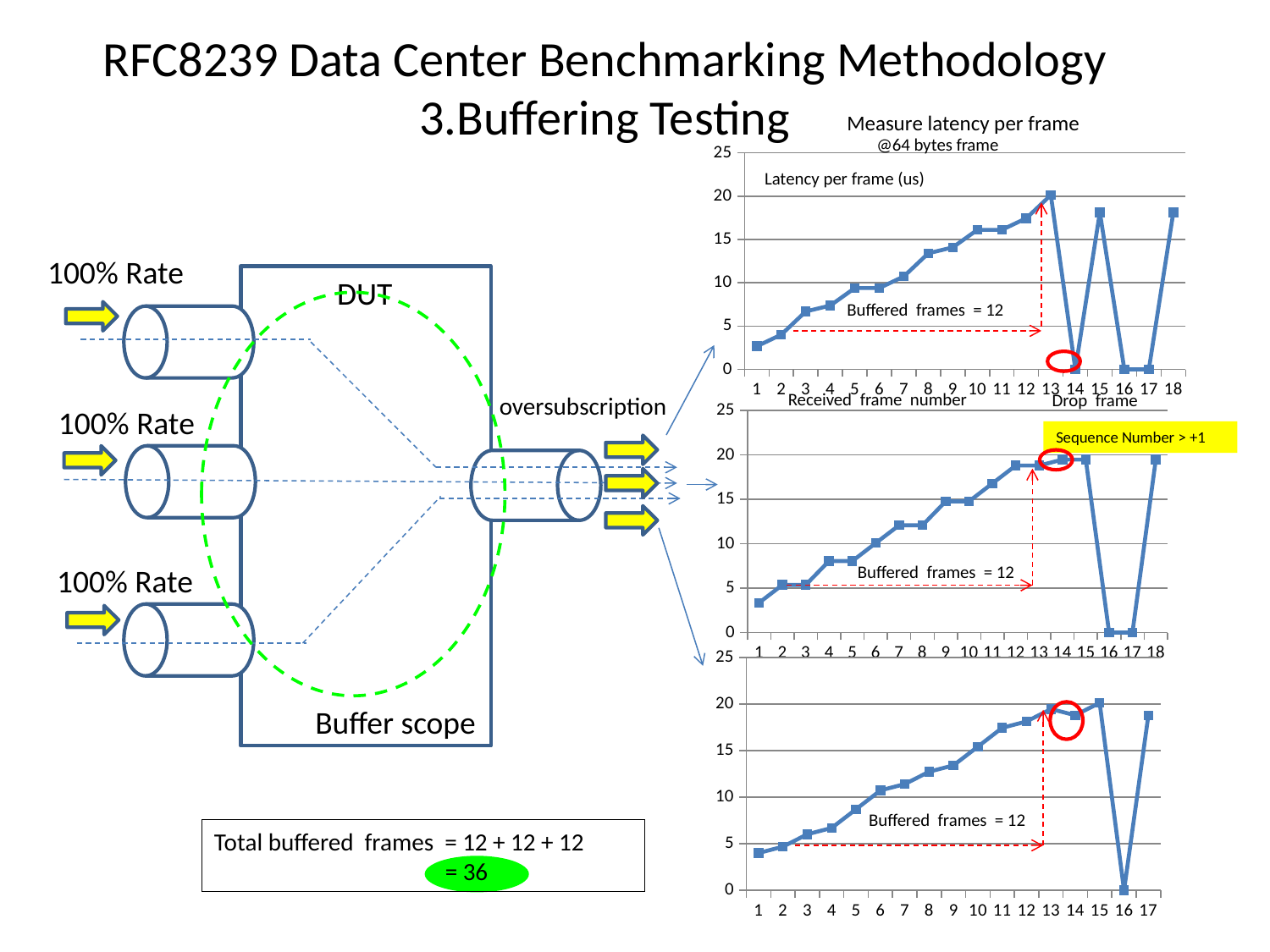
In the bottom chart, is the latency for frame 15 greater or less than 15? greater What type of chart is the top chart on the right of the slide? line chart In the top chart, is the latency for frame 1 greater or less than 5? less According to the annotation on the top chart, how many buffered frames are there? 12 In the top chart, do the latency values rise or fall from frame 1 to frame 13? rise In the top chart, which is larger, the latency for frame 13 or for frame 1? frame 13 What is the title of the top chart on the right? Measure latency per frame @64 bytes frame In the top chart, is the latency for frame 13 greater or less than 15? greater In the top chart, what is the latency value plotted for frame 16? 0 In the top chart, how many received frame numbers are shown on the x axis? 18 In the bottom chart, how many received frame numbers are shown on the x axis? 17